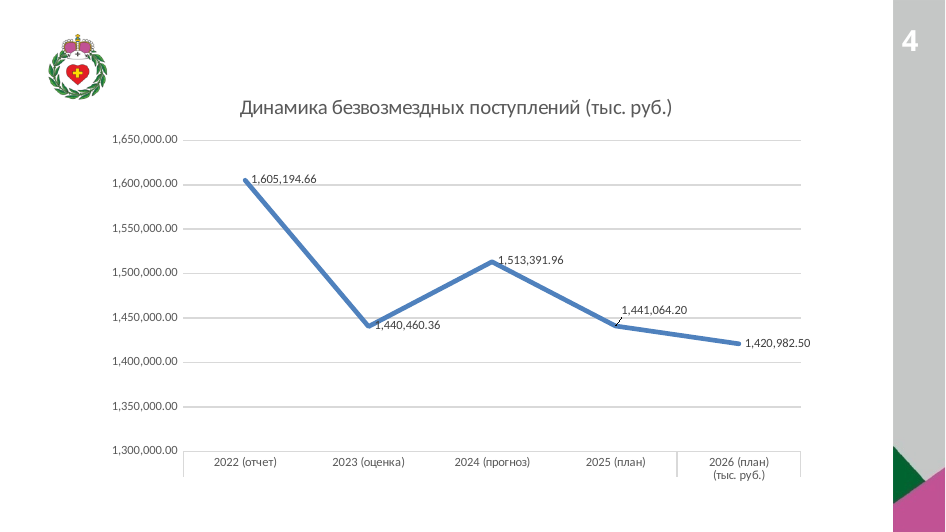
Which year has the lowest value? 2026 (план) What is the value for 2024 (прогноз)? 1,513,391.96 Which is larger, the value for 2022 (отчет) or the value for 2024 (прогноз)? 2022 (отчет) How many data points are plotted on the chart? 5 What is the value for 2026 (план)? 1,420,982.50 Is the value for 2024 (прогноз) greater or less than 1,500,000.00? greater What is the title of the chart? Динамика безвозмездных поступлений (тыс. руб.) Which year has the highest value? 2022 (отчет) What is the value for 2022 (отчет)? 1,605,194.66 What is the difference between the values for 2022 (отчет) and 2023 (оценка)? 164,734.30 What kind of chart is shown on the slide? line chart What is the value for 2023 (оценка)? 1,440,460.36